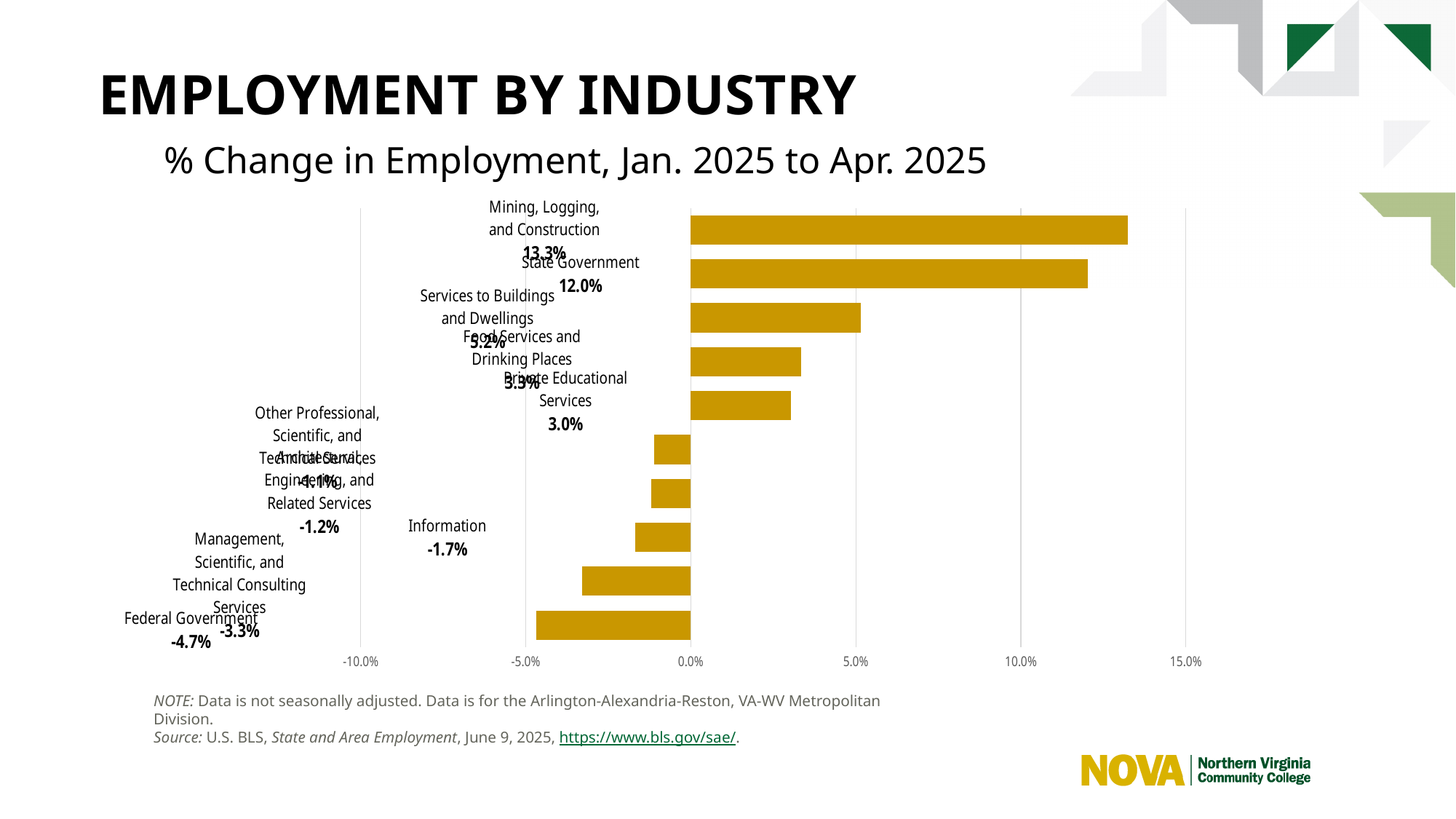
What type of chart is used on this slide? Bar chart Which industry has the lowest % change in employment? Federal Government What is the difference between the % change for Mining, Logging, and Construction and State Government? 1.3 percentage points Which industry has the highest % change in employment? Mining, Logging, and Construction What is the % change in employment for Private Educational Services? 3.0% Which has a larger % change in employment, Services to Buildings and Dwellings or Food Services and Drinking Places? Services to Buildings and Dwellings Is the value for State Government greater or less than 10.0%? greater What is the % change in employment for State Government? 12.0% What is the % change in employment for Federal Government? -4.7% How many industries are shown in the chart? 10 What is the % change in employment for Information? -1.7% What is the % change in employment for Mining, Logging, and Construction? 13.3%